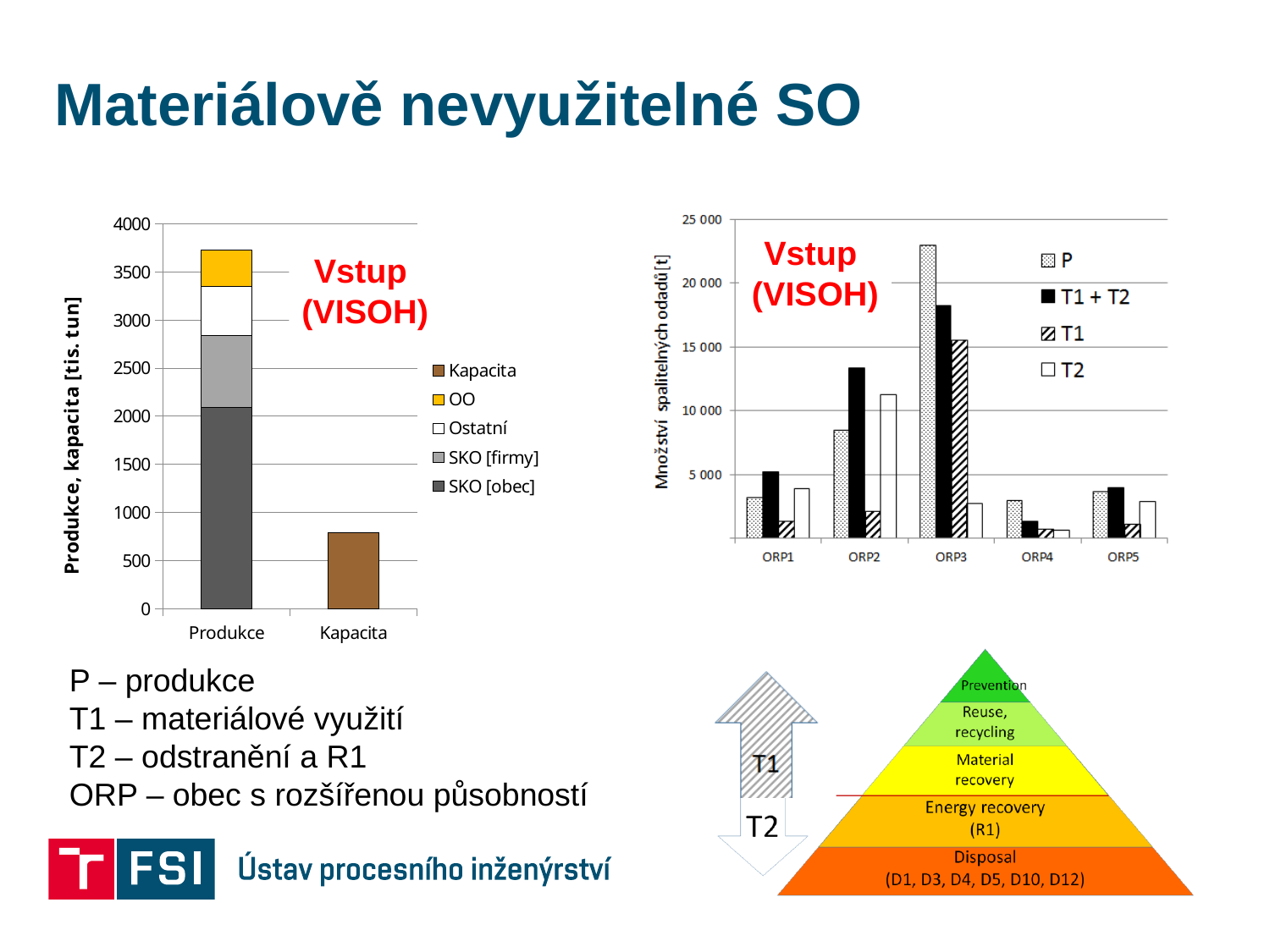
What kind of chart is the left chart on the slide? stacked bar chart How many categories are shown on the x axis of the left chart? 2 How many series does the legend of the right chart list? 4 In the left chart, which category has the taller bar, Produkce or Kapacita? Produkce In the right chart, is the value of P for ORP3 greater or less than 20 000? greater What is the y-axis label of the left chart? Produkce, kapacita [tis. tun] In the left chart, is the value for Kapacita greater or less than 1000? less How many ORP categories are shown on the x axis of the right chart? 5 In the right chart, for ORP2, which is larger, T1 or T2? T2 How many series does the legend of the left chart list? 5 In the left chart, is the total of the Produkce stacked bar greater or less than 3500? greater In the right chart, which ORP has the highest value for P? ORP3